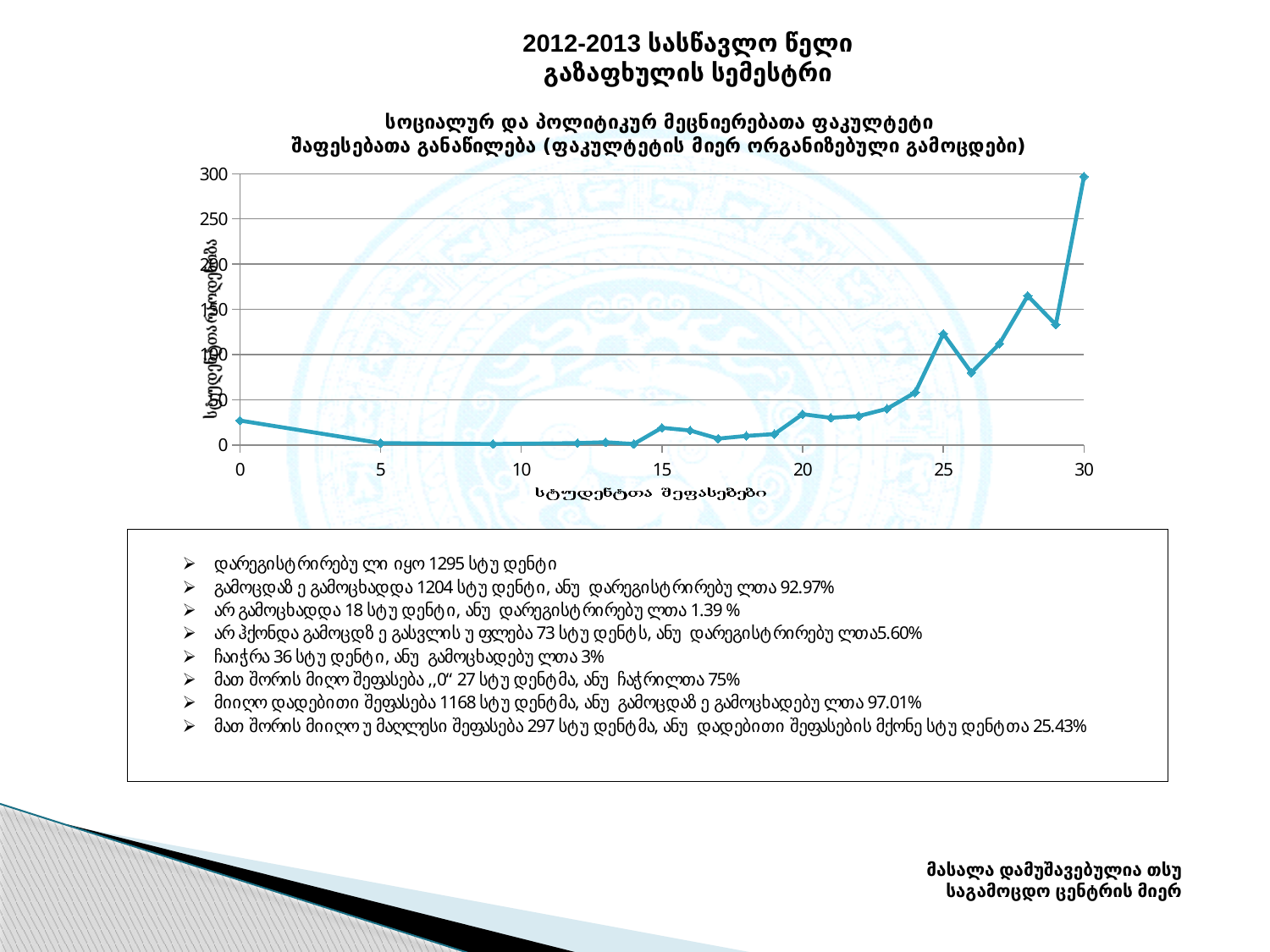
Overall, do the values rise or fall as the x-axis goes from 15 to 30? rise Is the value at x = 28 greater or less than 150? greater Which is larger, the value at x = 28 or the value at x = 29? x = 28 At which x-axis value (student grade) does the line reach its highest point? 30 Is the value at x = 30 greater or less than 250? greater Is the value at x = 25 greater or less than 100? greater What is the highest tick value shown on the y-axis? 300 What kind of chart is shown on the slide? line chart Which is larger, the value at x = 25 or the value at x = 26? x = 25